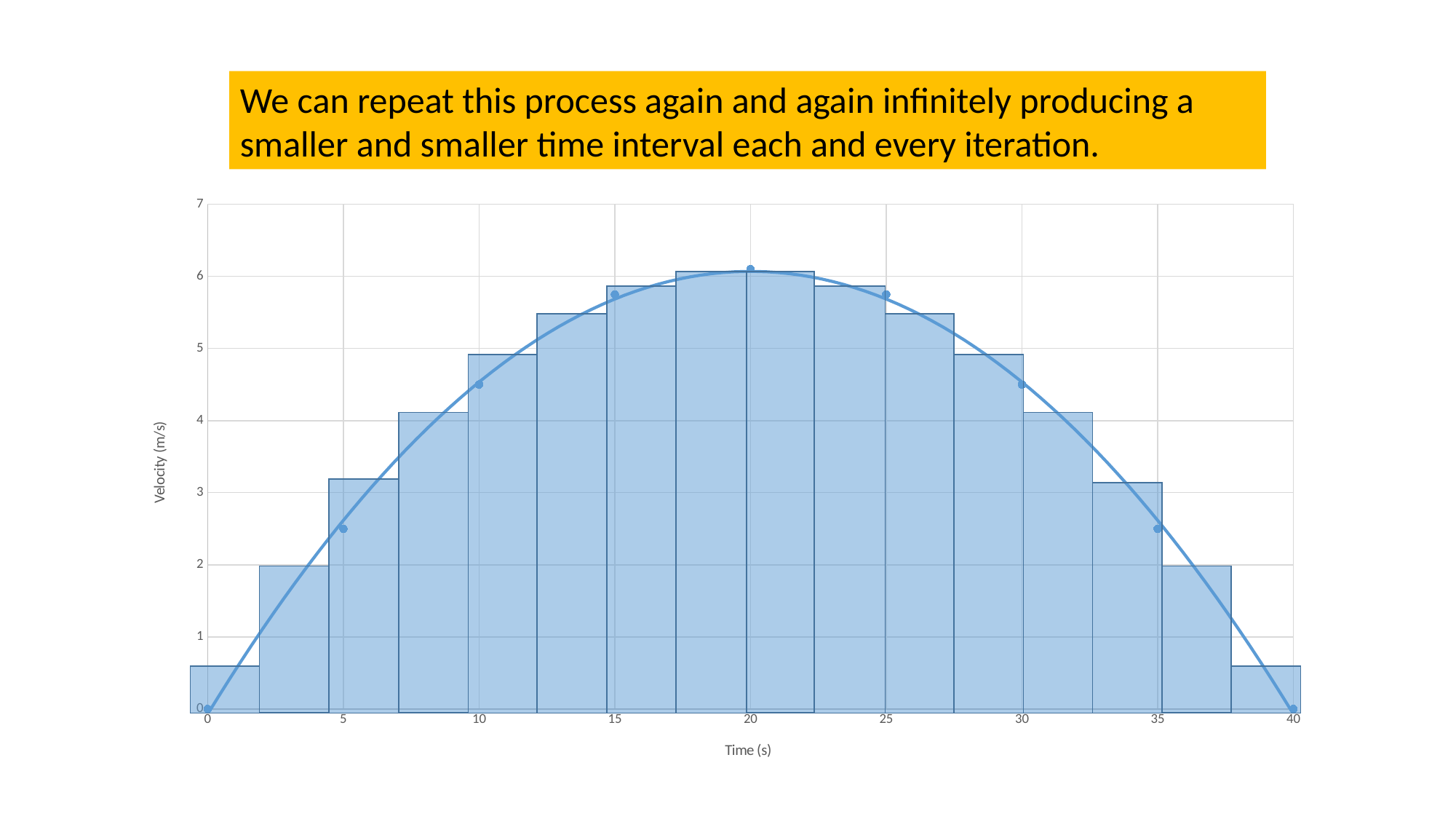
At which time is the velocity on the curve highest? 20 Is the velocity at 10 s greater or less than 4? greater Does the velocity rise or fall as time goes from 20 s to 40 s? fall Which has the higher velocity, 5 s or 10 s? 10 s Is the velocity at 20 s greater or less than 6? greater What kind of chart is shown on the slide? A bar chart with a line overlaid Is the velocity at 5 s greater or less than 3? less What is the label of the y axis? Velocity (m/s) What is the label of the x axis? Time (s) What is the velocity at time 0 s? 0